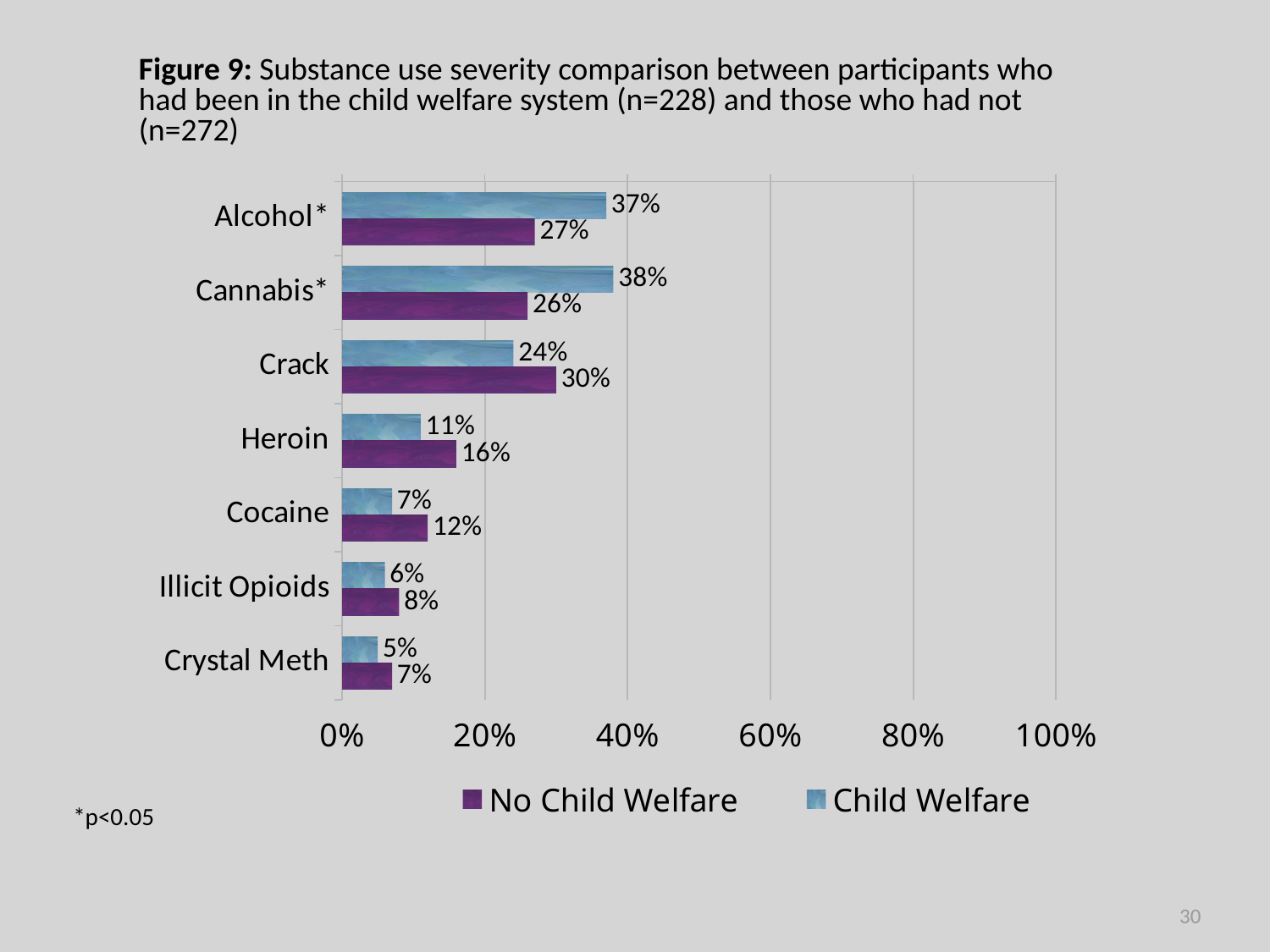
What is the difference between the Child Welfare and No Child Welfare values for Alcohol*? 10% For Cocaine, which series has the larger value, Child Welfare or No Child Welfare? No Child Welfare Is the No Child Welfare value for Crack greater or less than 20%? greater Which colour represents the No Child Welfare series? Purple What is the No Child Welfare value for Crack? 30% Which category has the lowest No Child Welfare value? Crystal Meth Which category has the highest Child Welfare value? Cannabis* What kind of chart is shown on the slide? Bar chart How many series does the legend list? 2 What is the Child Welfare value for Cannabis*? 38% What is the Child Welfare value for Heroin? 11% How many substance categories are shown on the chart? 7